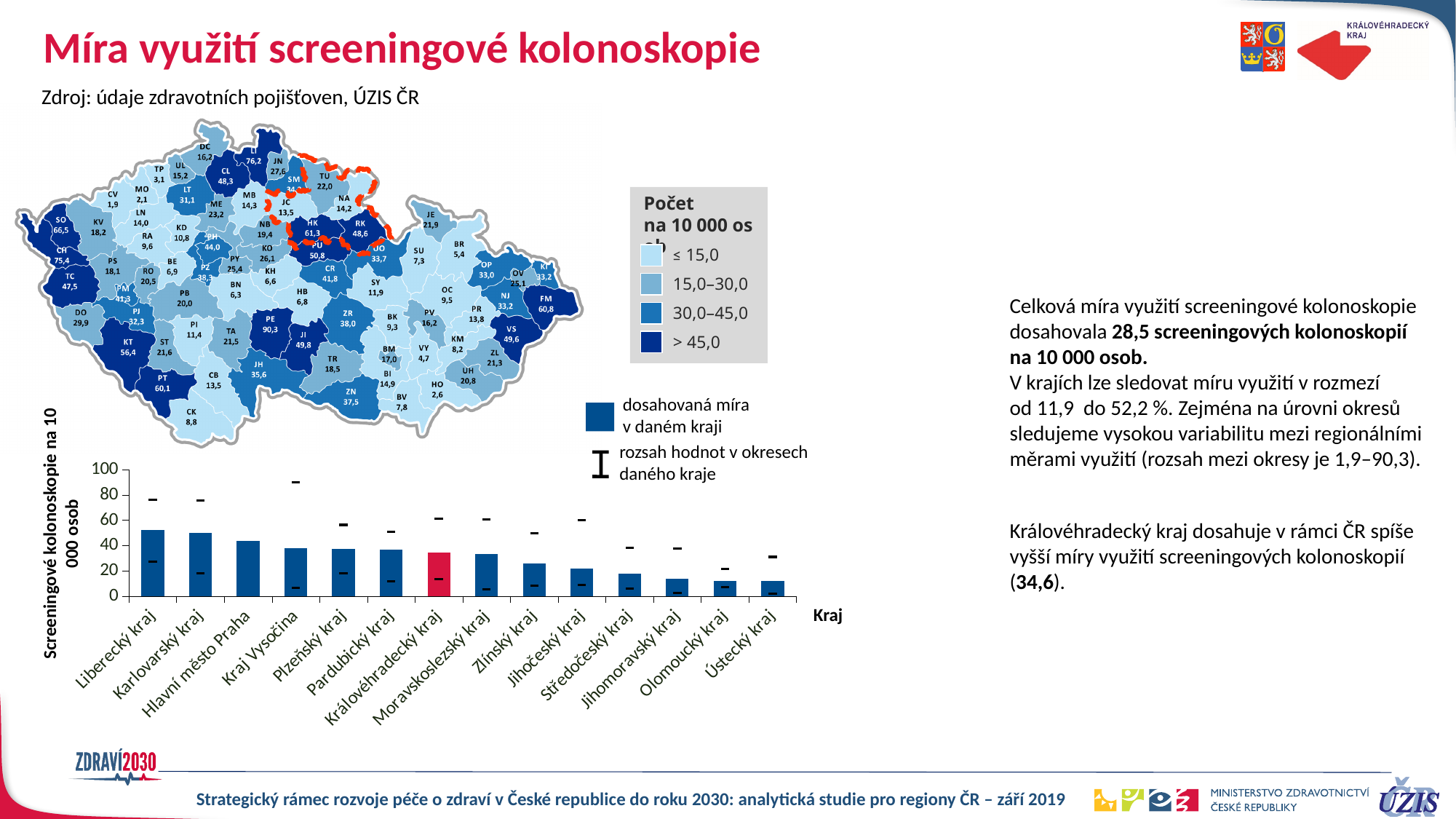
In the bar chart, is the value for Zlínský kraj greater or less than 20? greater In the bar chart, is the value for Jihomoravský kraj greater or less than 20? less In the bar chart, which is larger: the value for Karlovarský kraj or the value for Ústecký kraj? Karlovarský kraj How many regions (kraje) are shown on the x axis of the bar chart? 14 Which region's bar is highlighted in red in the bar chart? Královéhradecký kraj According to the slide, what screening colonoscopy rate does Královéhradecký kraj reach? 34,6 What kind of chart is shown at the bottom left of the slide? bar chart In the bar chart, is the value for Hlavní město Praha greater or less than 40? greater How many value categories does the map legend (Počet na 10 000 osob) list? 4 Which region has the highest bar in the bar chart? Liberecký kraj Do the bar values rise or fall from left to right along the x axis of the bar chart? fall